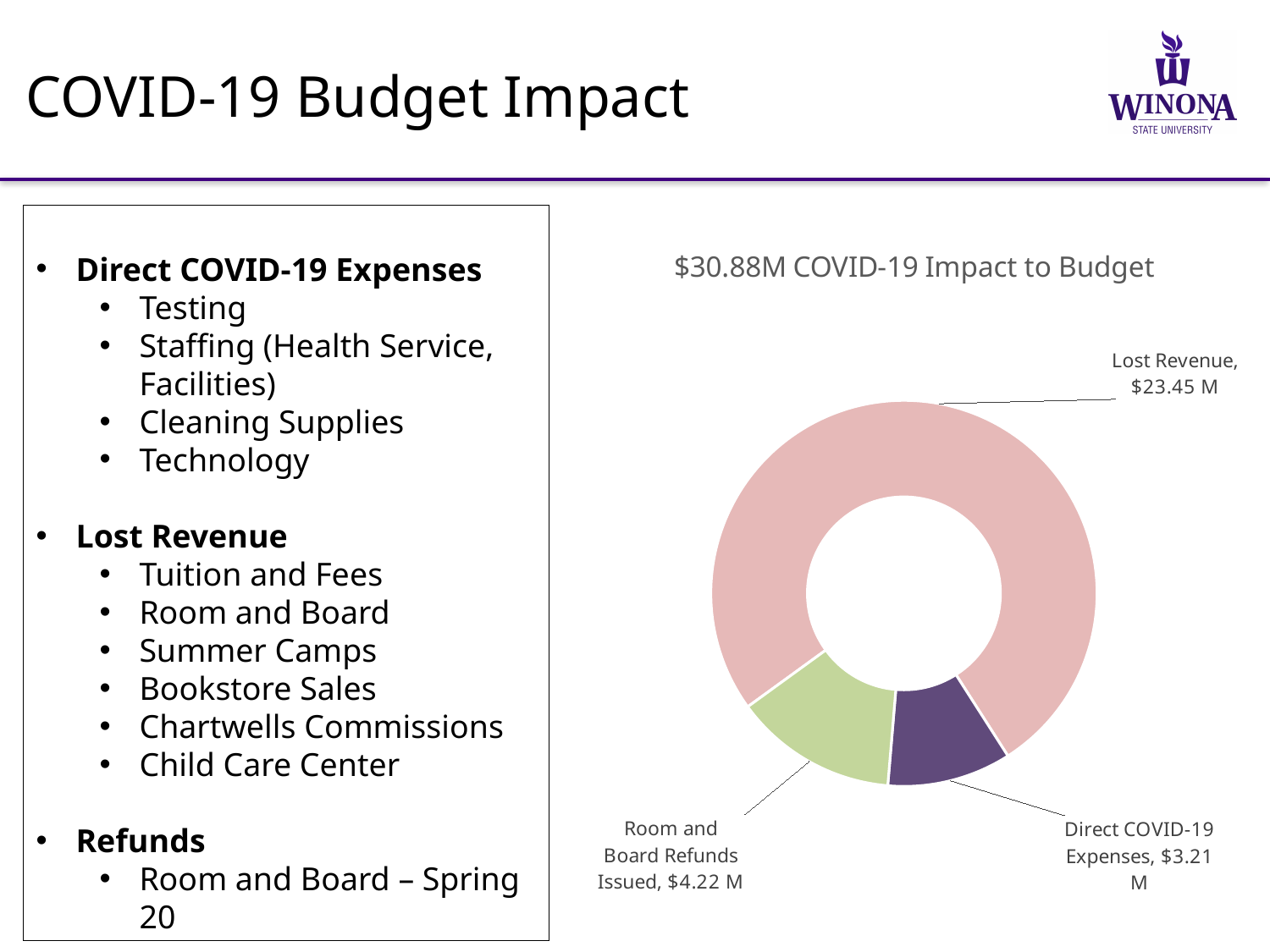
Which is larger, Room and Board Refunds Issued or Direct COVID-19 Expenses? Room and Board Refunds Issued Which category has the smallest slice in the chart? Direct COVID-19 Expenses What is the value of the Lost Revenue slice in the chart? $23.45 M What is the title of the chart? $30.88M COVID-19 Impact to Budget What is the value of the Room and Board Refunds Issued slice in the chart? $4.22 M What is the difference between the Room and Board Refunds Issued value and the Direct COVID-19 Expenses value? $1.01 M How many categories are shown in the chart? 3 Which category has the largest slice in the chart? Lost Revenue What is the value of the Direct COVID-19 Expenses slice in the chart? $3.21 M What is the difference between the Lost Revenue value and the Room and Board Refunds Issued value? $19.23 M What is the total of the three values shown in the chart? $30.88 M What kind of chart is shown on the slide? doughnut chart